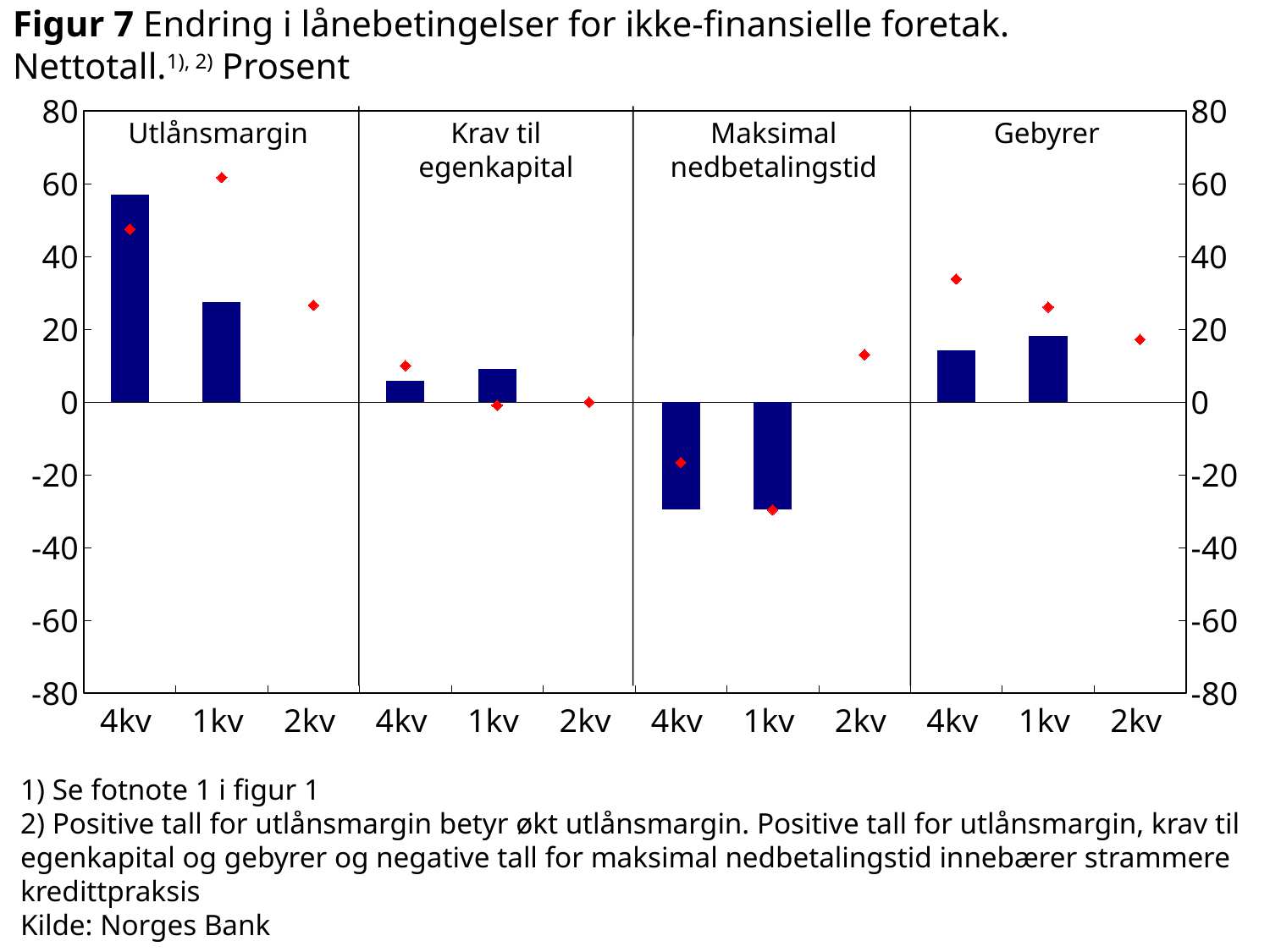
Which panel contains the tallest bar in the chart? Utlånsmargin What source is cited for the chart? Norges Bank Is the 4kv bar for Utlånsmargin greater or less than 40? greater What kind of chart is shown in Figur 7? bar chart In the Utlånsmargin panel, do the bars rise or fall from 4kv to 1kv? fall Is the 1kv bar for Krav til egenkapital greater or less than 20? less Is the 4kv bar for Maksimal nedbetalingstid greater or less than -20? less How many lending-condition panels (categories) does the chart show? 4 Which panel has bars that are negative? Maksimal nedbetalingstid In the Utlånsmargin panel, which bar is larger, 4kv or 1kv? 4kv How many quarters are shown on the x axis within each panel? 3